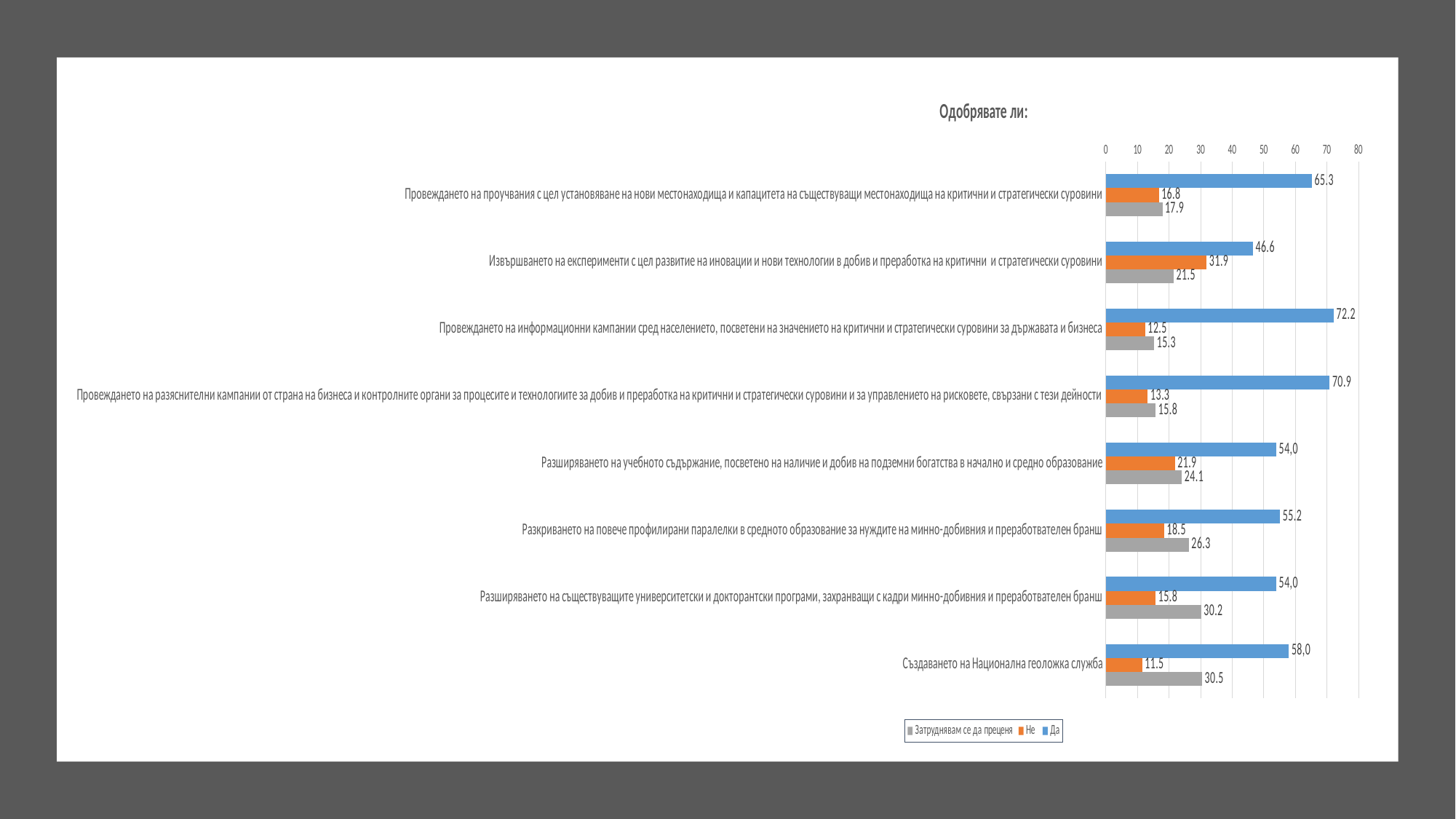
How many categories (statements) are shown in the chart? 8 What type of chart is shown on the slide? Bar chart Which category has the highest 'Да' value? Провеждането на информационни кампании сред населението, посветени на значението на критични и стратегически суровини за държавата и бизнеса Which category has the lowest 'Да' value? Извършването на експерименти с цел развитие на иновации и нови технологии в добив и преработка на критични и стратегически суровини What is the 'Да' value for 'Създаването на Национална геоложка служба'? 58,0 What is the 'Затруднявам се да преценя' value for 'Разширяването на съществуващите университетски и докторантски програми, захранващи с кадри минно-добивния и преработвателен бранш'? 30.2 Which category has the lowest 'Не' value? Създаването на Национална геоложка служба How many series does the legend list? 3 What is the title of the chart? Одобрявате ли: What is the difference between the 'Да' values for 'Провеждането на информационни кампании сред населението...' (72.2) and 'Провеждането на проучвания с цел установяване на нови местонаходища...' (65.3)? 6.9 For 'Разкриването на повече профилирани паралелки в средното образование...', which is larger: the 'Не' value or the 'Затруднявам се да преценя' value? Затруднявам се да преценя What is the 'Не' value for 'Извършването на експерименти с цел развитие на иновации и нови технологии в добив и преработка на критични и стратегически суровини'? 31.9